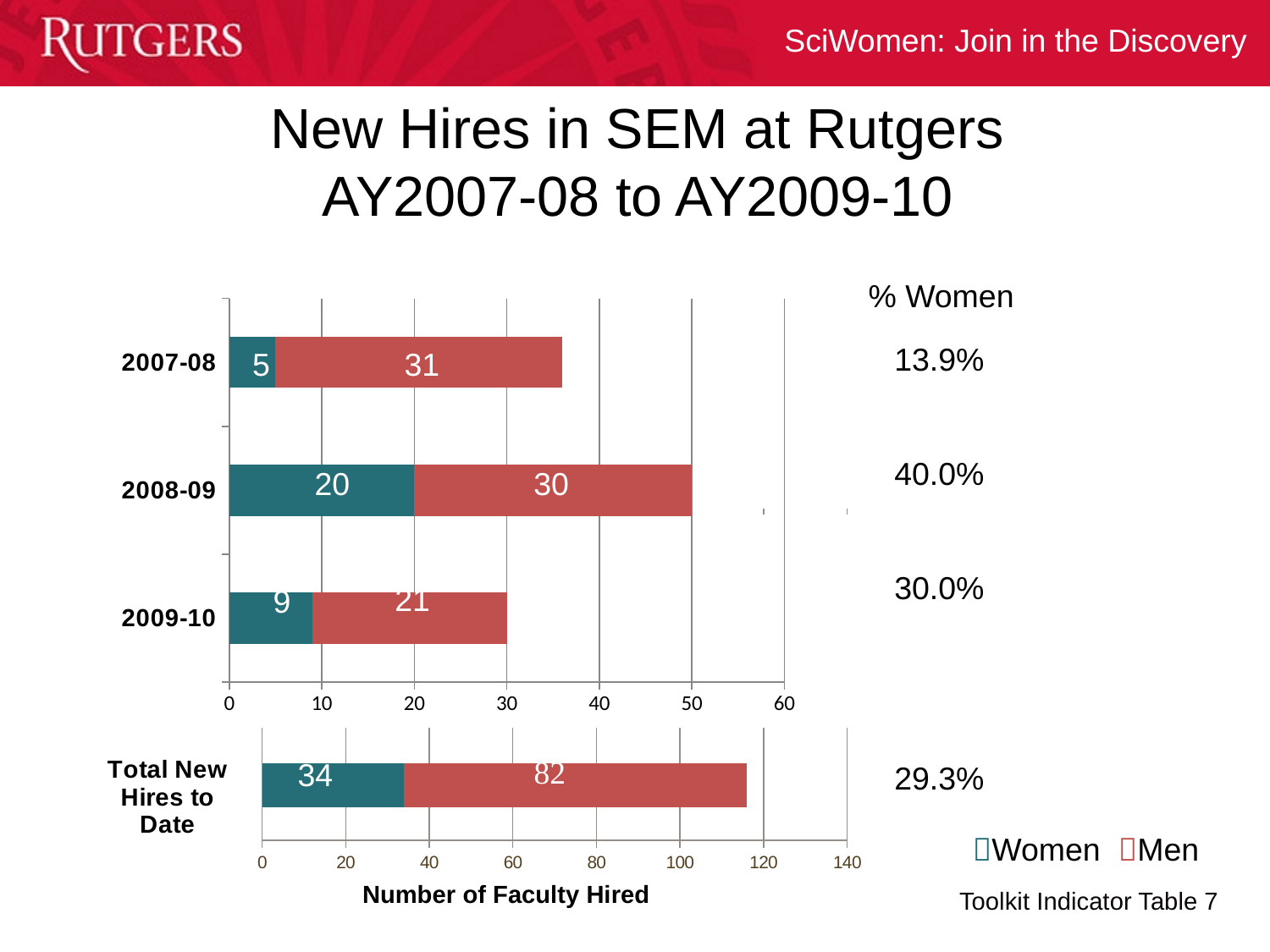
In the upper chart, how many men were hired in 2007-08? 31 In the lower chart, what is the total number of new hires to date? 116 How many series does the legend list? 2 In the lower chart, how many men are counted in Total New Hires to Date? 82 In the upper chart, which academic year had the highest number of women hired? 2008-09 In the lower chart, how many women are counted in Total New Hires to Date? 34 In the upper chart, how many women were hired in 2008-09? 20 What kind of chart is the upper chart? Stacked bar chart In the upper chart, what is the difference between the number of men and women hired in 2009-10? 12 In the upper chart, which academic year had the lowest number of men hired? 2009-10 In the upper chart, what is the total number of faculty hired in 2008-09? 50 In the upper chart, were more women hired in 2009-10 or in 2007-08? 2009-10